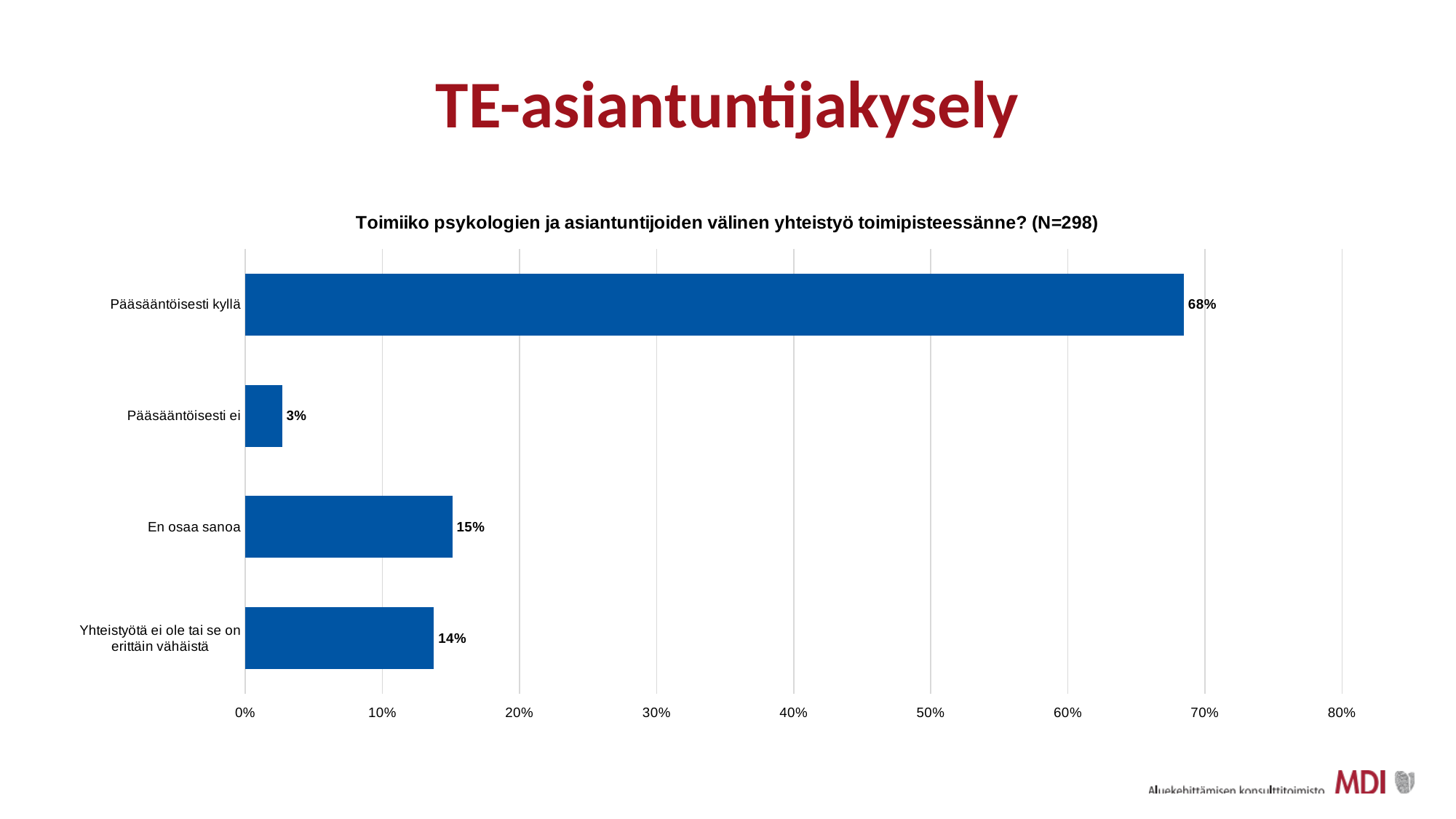
What is the value for "Pääsääntöisesti kyllä"? 68% What is the value for "Pääsääntöisesti ei"? 3% What is the value for "Yhteistyötä ei ole tai se on erittäin vähäistä"? 14% Which category has the highest value? Pääsääntöisesti kyllä What kind of chart is shown on the slide? bar chart Is the value for "Pääsääntöisesti kyllä" greater or less than 60%? greater Which category has the lowest value? Pääsääntöisesti ei Which is larger, the value for "En osaa sanoa" or the value for "Pääsääntöisesti ei"? En osaa sanoa How many categories are shown in the chart? 4 What is the difference between the values for "Pääsääntöisesti kyllä" and "En osaa sanoa"? 53% What is the value for "En osaa sanoa"? 15% What is the N value stated in the chart title? 298